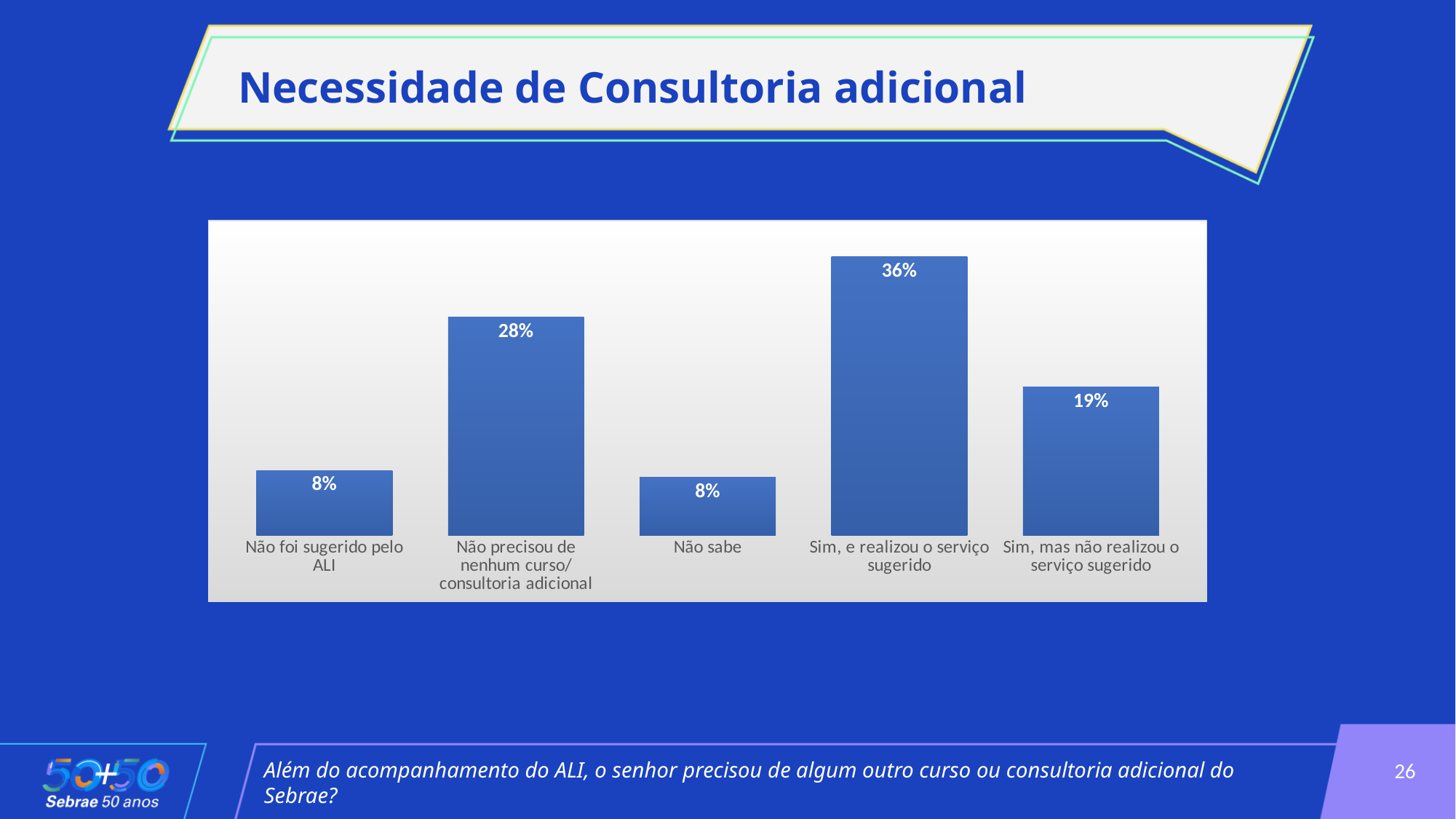
What is the value for "Sim, e realizou o serviço sugerido"? 36% What is the value for "Não sabe"? 8% Which category has the highest value? Sim, e realizou o serviço sugerido What is the difference between "Não precisou de nenhum curso/ consultoria adicional" and "Não foi sugerido pelo ALI"? 20% Which is larger: "Não precisou de nenhum curso/ consultoria adicional" or "Sim, mas não realizou o serviço sugerido"? Não precisou de nenhum curso/ consultoria adicional What is the value for "Sim, mas não realizou o serviço sugerido"? 19% What is the title of the slide? Necessidade de Consultoria adicional What kind of chart is shown on the slide? Bar chart What is the value for "Não precisou de nenhum curso/ consultoria adicional"? 28% How many categories are shown in the chart? 5 How many categories share the lowest value of 8%? 2 What is the difference between "Sim, e realizou o serviço sugerido" and "Sim, mas não realizou o serviço sugerido"? 17%